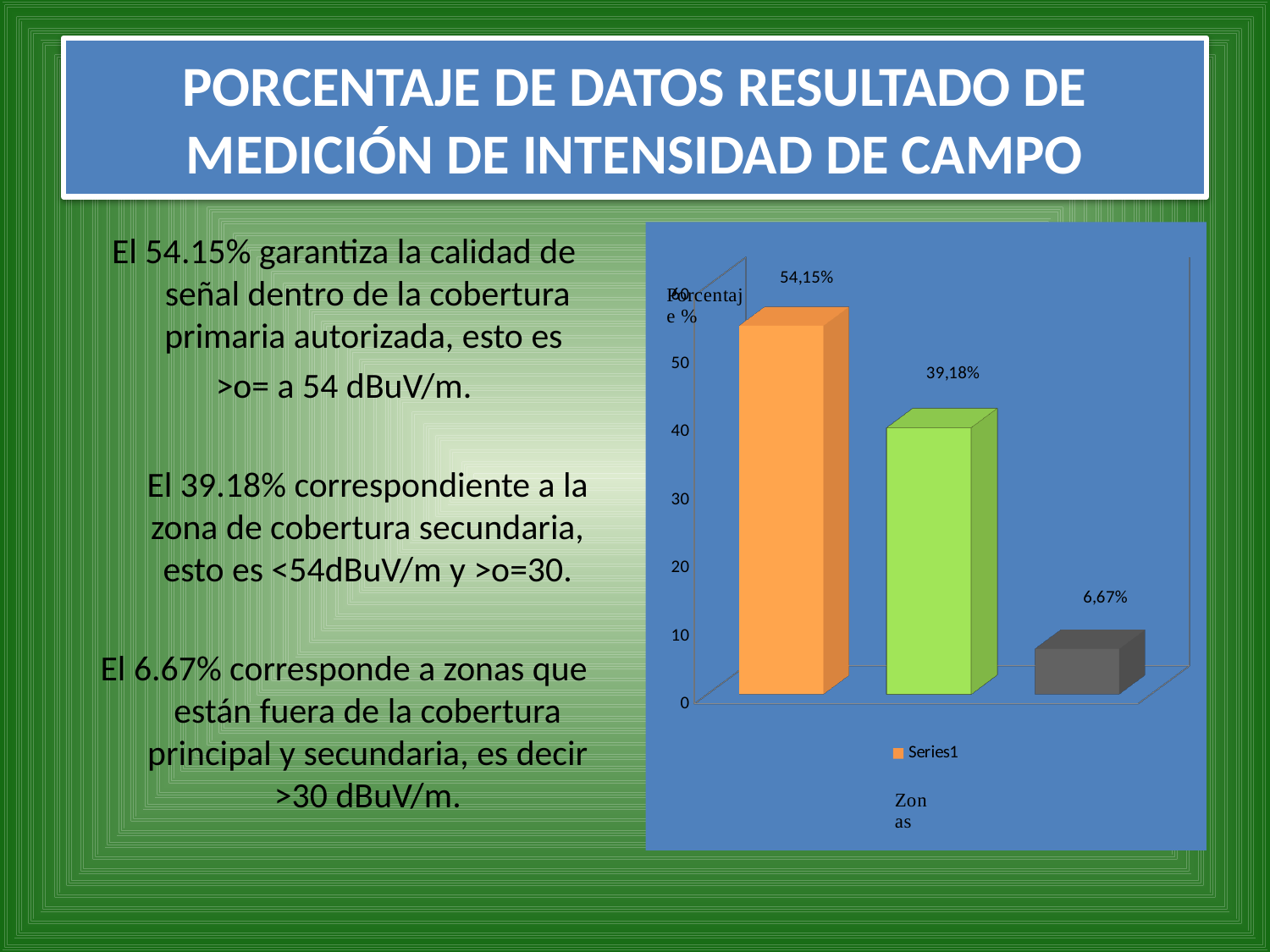
Which is larger, the value of the green bar or the value of the grey bar? the green bar What type of chart is shown on the slide? bar chart What is the name of the series shown in the chart legend? Series1 What is the data label on the third (grey) bar of the chart? 6,67% Which bar has the highest value in the chart? the first (orange) bar, 54,15% Which bar has the lowest value in the chart? the third (grey) bar, 6,67% What is the data label on the second (green) bar of the chart? 39,18% How many bars are plotted in the chart? 3 How many series does the chart legend list? 1 What is the difference between the first bar (54,15%) and the second bar (39,18%)? 14,97% What is the data label on the first (orange) bar of the chart? 54,15% Do the bar values rise or fall from left to right across the chart? fall